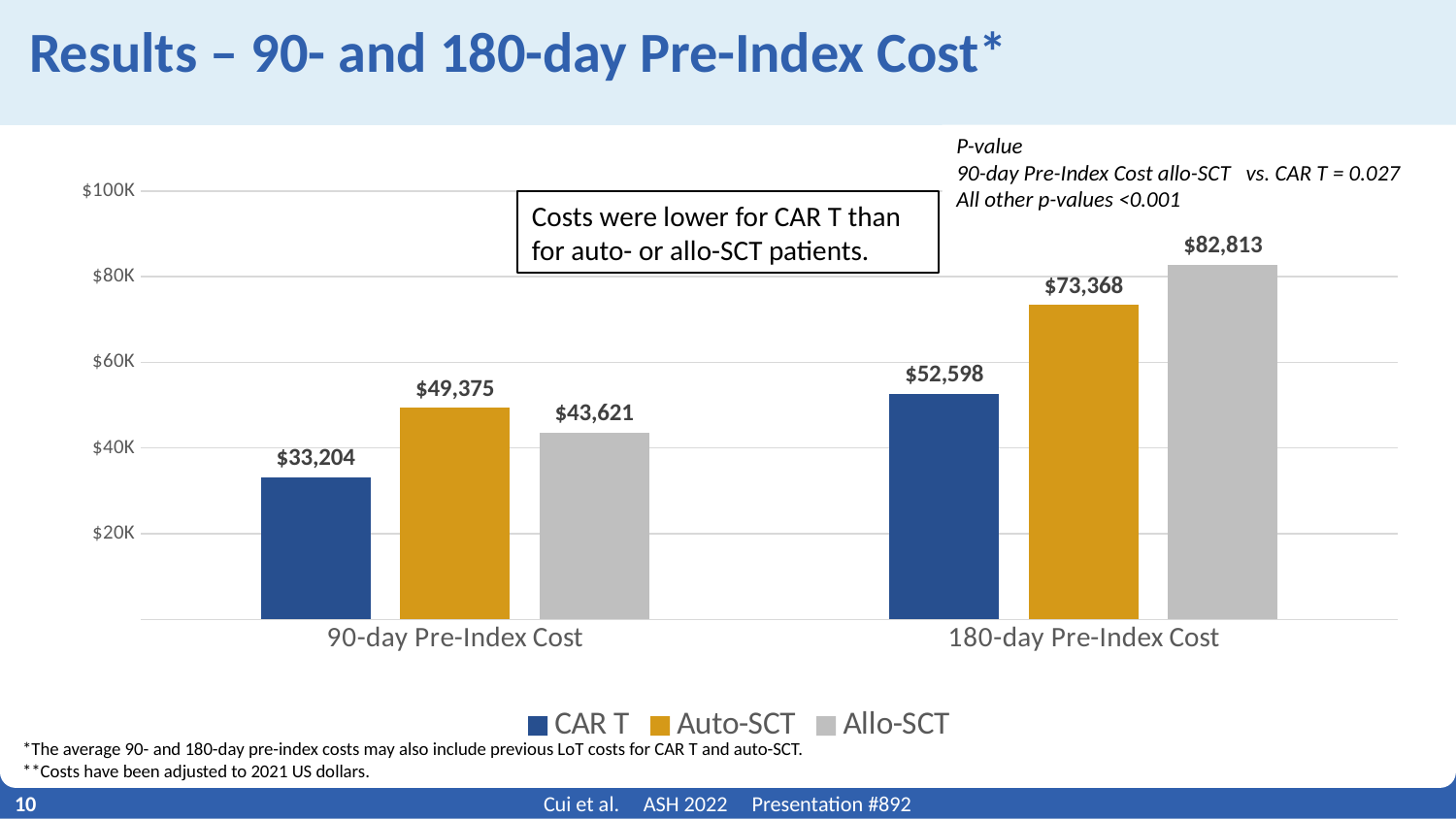
What is the 180-day Pre-Index Cost for Allo-SCT? $82,813 Which series has the highest 180-day Pre-Index Cost? Allo-SCT What is the 90-day Pre-Index Cost for CAR T? $33,204 Is the 180-day Pre-Index Cost for CAR T greater or less than $60K? less How many series does the legend list? 3 What kind of chart is shown on the slide? Bar chart Which colour represents Auto-SCT in the chart? Gold/yellow What is the difference between the Allo-SCT and Auto-SCT 180-day Pre-Index Costs? $9,445 Which series has the lowest 90-day Pre-Index Cost? CAR T For the 90-day Pre-Index Cost, which is larger: Auto-SCT or Allo-SCT? Auto-SCT What is the 180-day Pre-Index Cost for Auto-SCT? $73,368 What is the difference between the Auto-SCT and CAR T 90-day Pre-Index Costs? $16,171